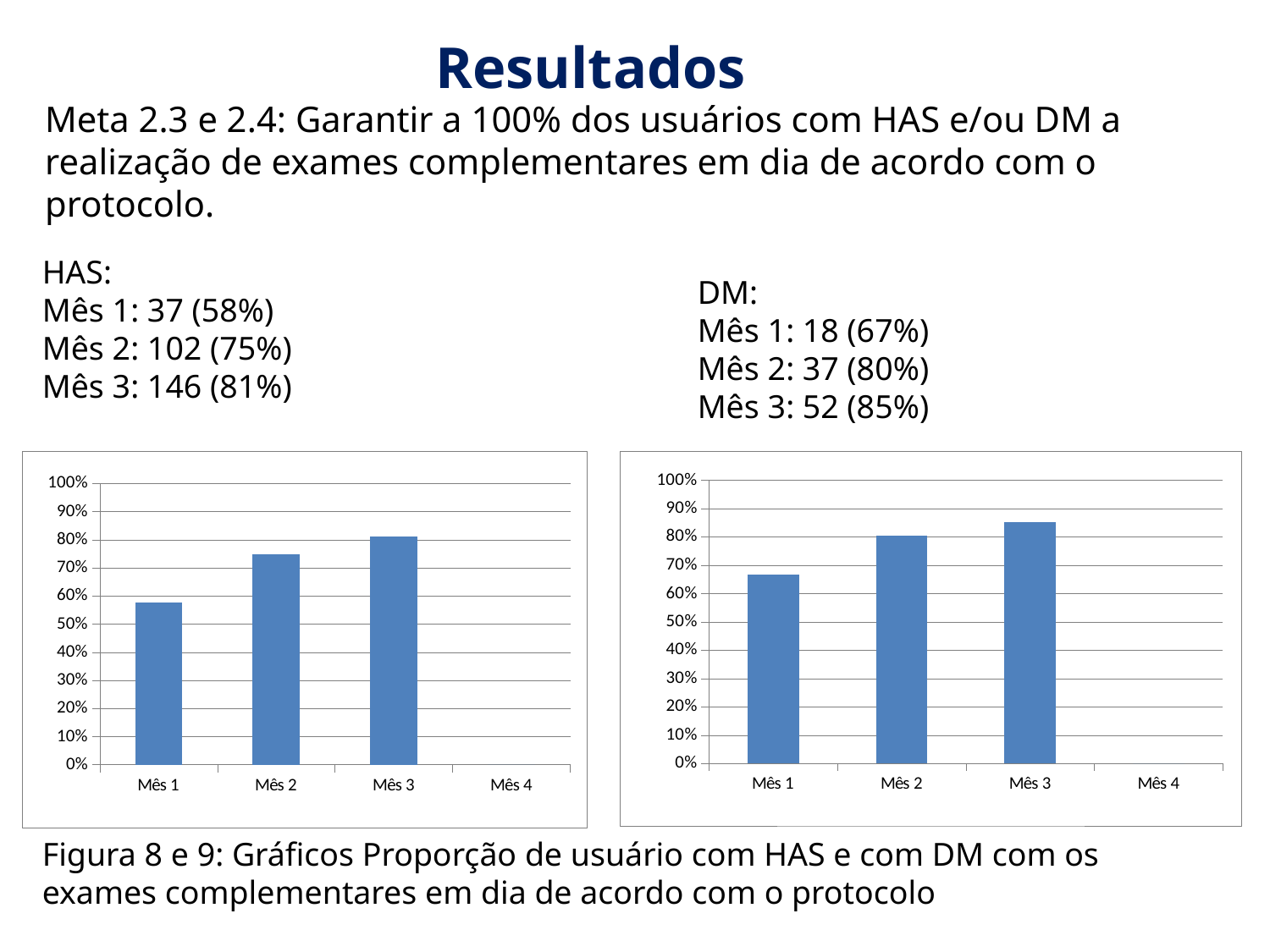
In the right chart (DM), what is the difference between the values for Mês 2 and Mês 1? 13% In the right chart (DM), what is the value for Mês 1? 67% In the left chart (HAS), what is the value for Mês 3? 81% In the right chart (DM), is the value for Mês 3 greater or less than 80%? greater How many categories are shown on the x axis of the left chart (HAS)? 4 In the left chart (HAS), what is the difference between the values for Mês 3 and Mês 1? 23% In the left chart (HAS), which month has the highest value? Mês 3 What type of chart is the right chart (DM)? bar chart In the left chart (HAS), do the values rise or fall from Mês 1 to Mês 3? rise In the left chart (HAS), is the value for Mês 1 greater or less than 60%? less In the right chart (DM), which is larger, the value for Mês 2 or the value for Mês 1? Mês 2